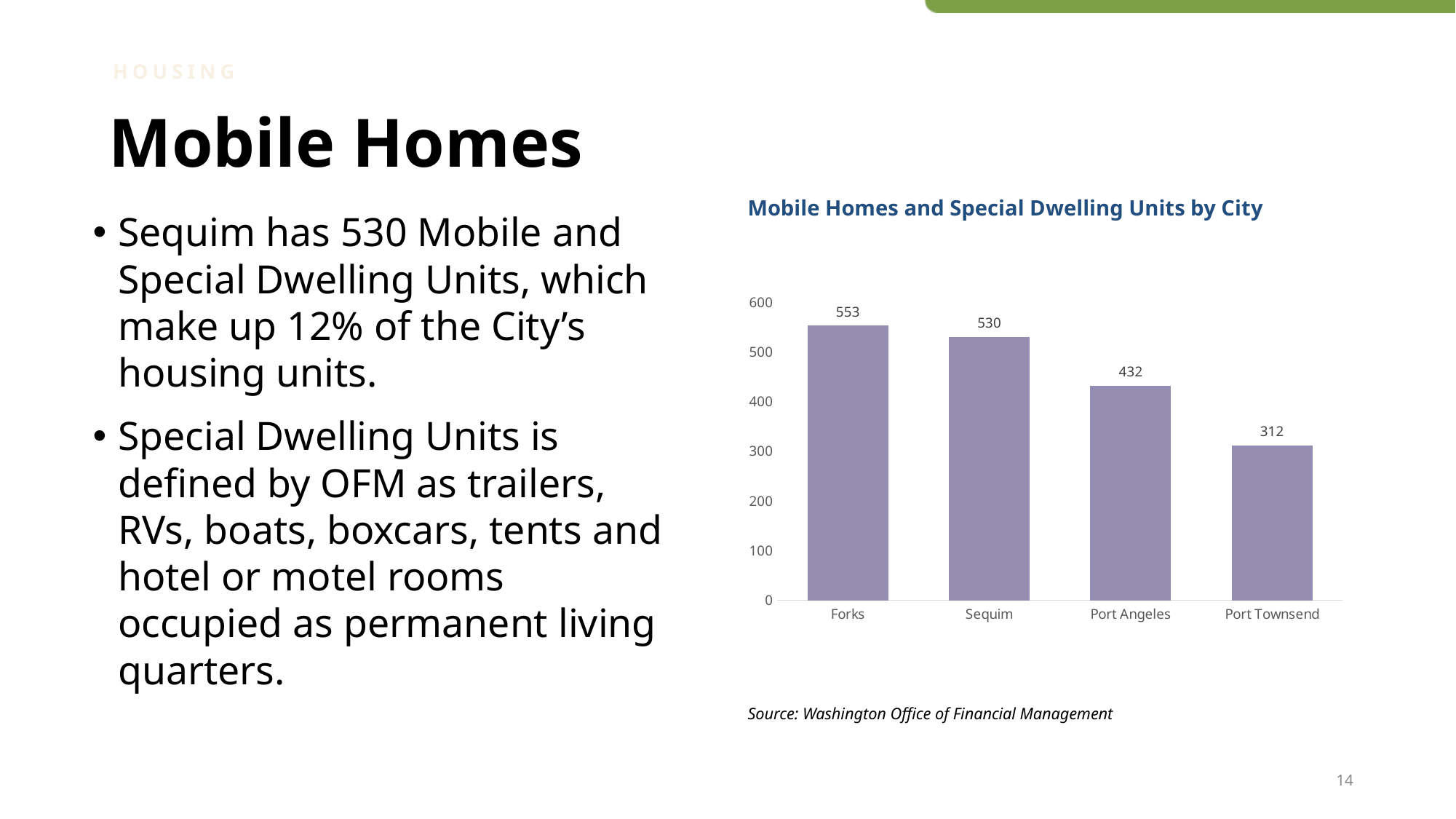
Which is larger, the value for Sequim or the value for Port Angeles? Sequim What is the value for Port Angeles in the chart? 432 What kind of chart is shown on the slide? Bar chart What is the difference between the values for Port Angeles and Port Townsend? 120 Which city has the lowest number of mobile homes and special dwelling units? Port Townsend What is the value for Forks in the chart? 553 What is the title of the chart? Mobile Homes and Special Dwelling Units by City What is the difference between the values for Forks and Sequim? 23 What is the value for Sequim in the chart? 530 Which city has the highest number of mobile homes and special dwelling units? Forks How many cities are shown in the chart? 4 What is the value for Port Townsend in the chart? 312